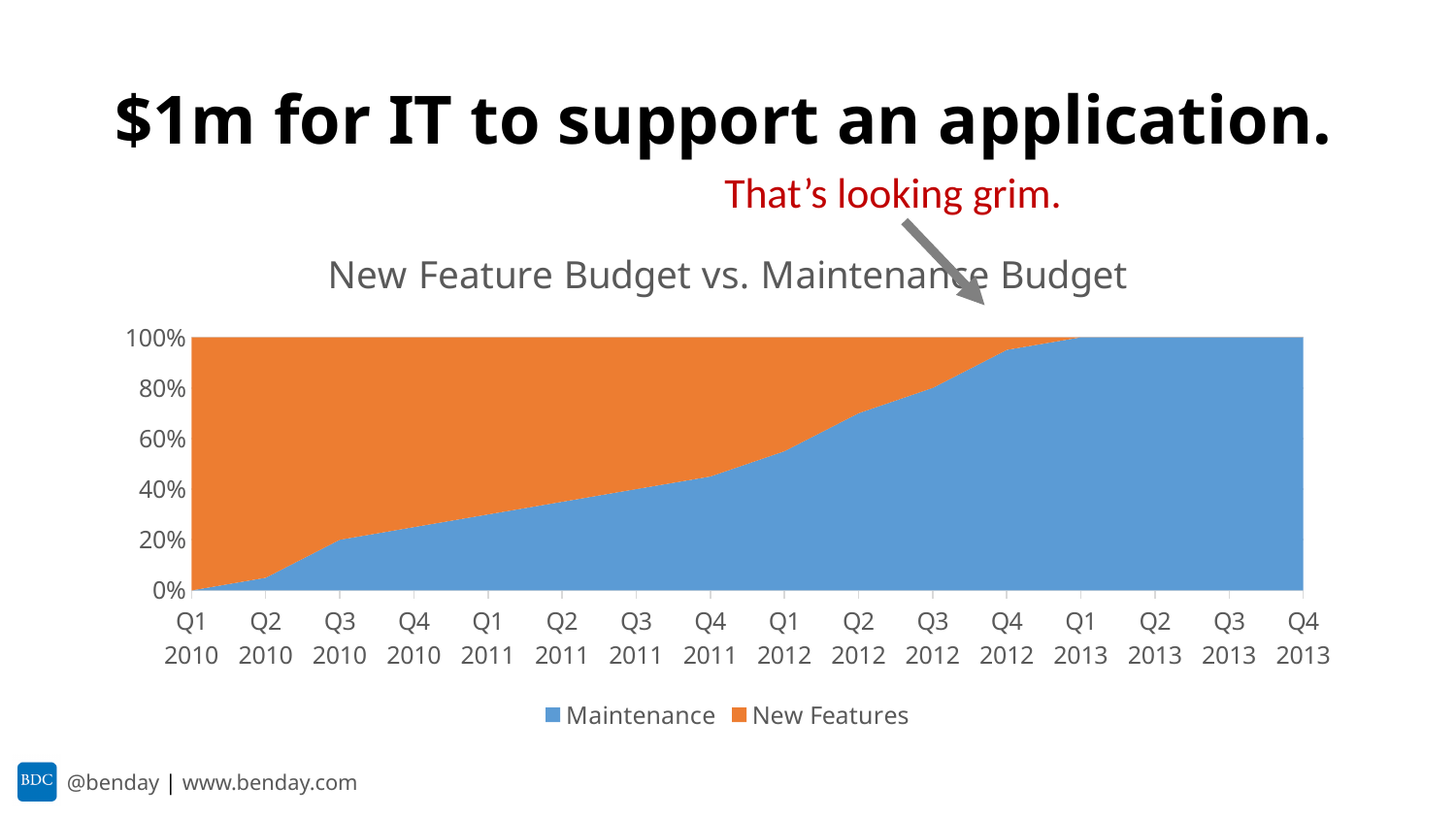
In Q1 2010, which series has the larger share: Maintenance or New Features? New Features How many quarters are shown along the x axis? 16 Is the Maintenance share in Q1 2010 greater or less than 20%? less In Q4 2013, which series has the larger share: Maintenance or New Features? Maintenance Which series is shown in blue? Maintenance Is the Maintenance share in Q2 2012 greater or less than 60%? greater Does the Maintenance share rise or fall from Q1 2010 to Q4 2013? Rise In which quarter is the Maintenance share lowest? Q1 2010 Is the Maintenance share in Q4 2013 greater or less than 80%? greater What is the title of the chart? New Feature Budget vs. Maintenance Budget What kind of chart is shown on the slide? Area chart How many series does the legend list? 2